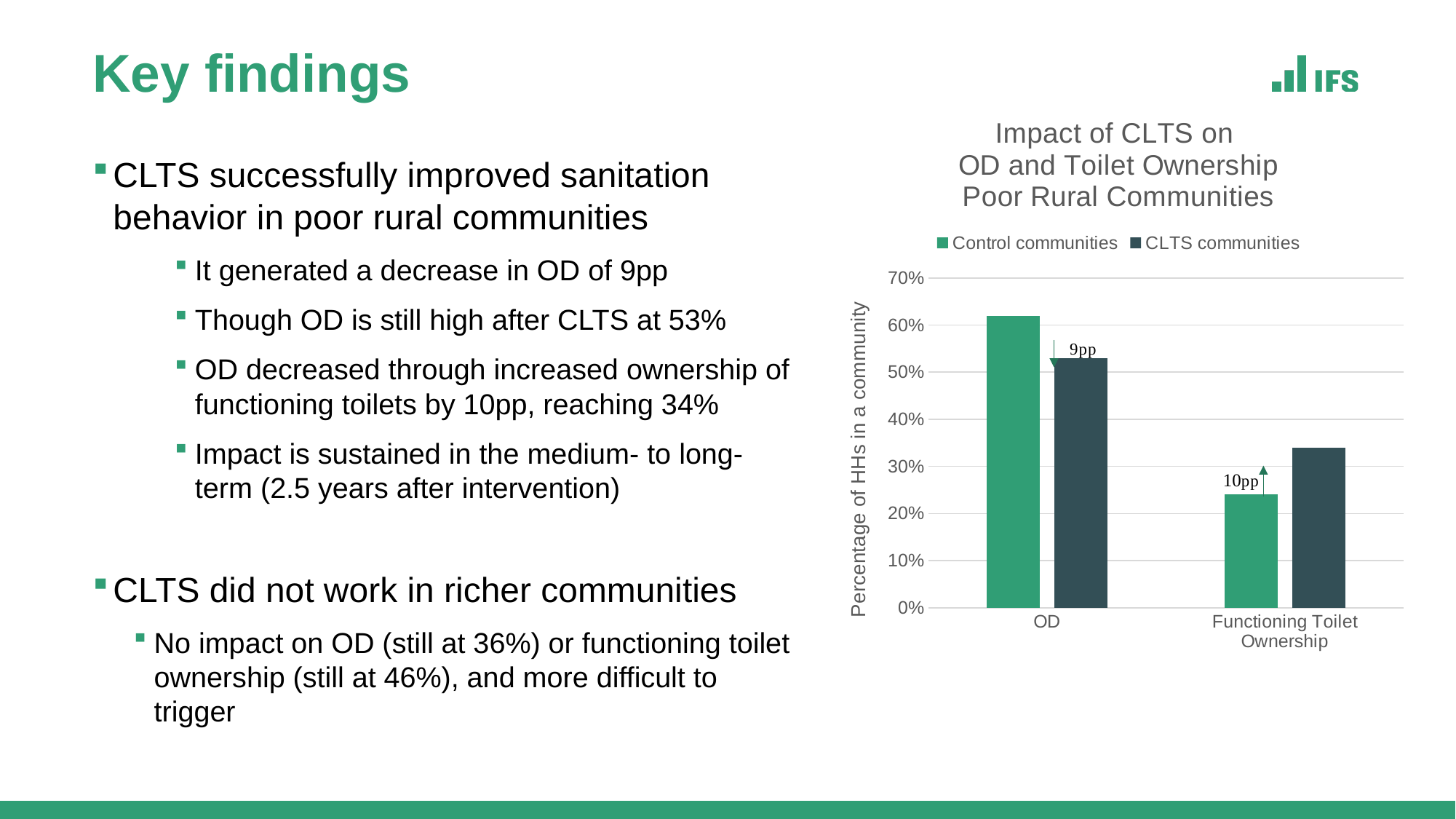
For Functioning Toilet Ownership, which is larger: Control communities or CLTS communities? CLTS communities How many categories are shown on the x axis of the chart? 2 Is the value for CLTS communities in Functioning Toilet Ownership greater or less than 30%? greater What difference between Control and CLTS communities is annotated on the chart for OD? 9pp How many series does the chart legend list? 2 For OD, which is larger: Control communities or CLTS communities? Control communities What difference between Control and CLTS communities is annotated on the chart for Functioning Toilet Ownership? 10pp Which category has the highest bar for Control communities? OD Is the value for Control communities in OD greater or less than 50%? greater Is the value for CLTS communities in OD greater or less than 60%? less What kind of chart is shown on the slide? bar chart